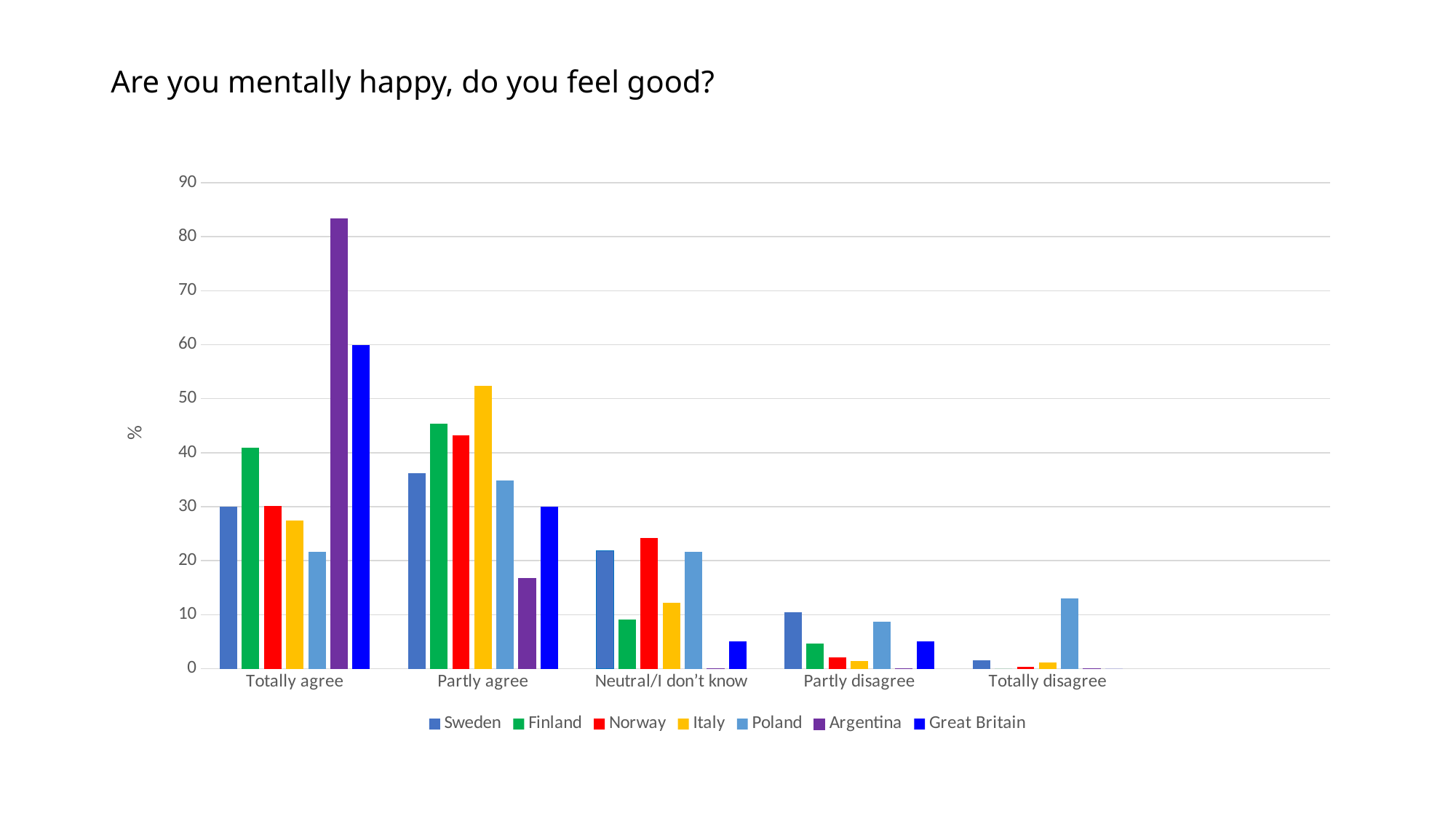
Which country has the highest value for 'Totally agree'? Argentina Is the value for Great Britain in 'Totally agree' greater or less than 70? less How many series does the legend list? 7 What kind of chart is shown on the slide? bar chart How many response categories are shown on the x axis? 5 Is the value for Argentina in 'Totally agree' greater or less than 80? greater What is the label on the y axis? % Is the value for Finland in 'Partly agree' greater or less than 50? less Which country has the lowest value for 'Partly agree'? Argentina Which country has the highest value for 'Partly agree'? Italy Which country has the highest value for 'Totally disagree'? Poland In 'Totally agree', which is larger: Finland or Sweden? Finland